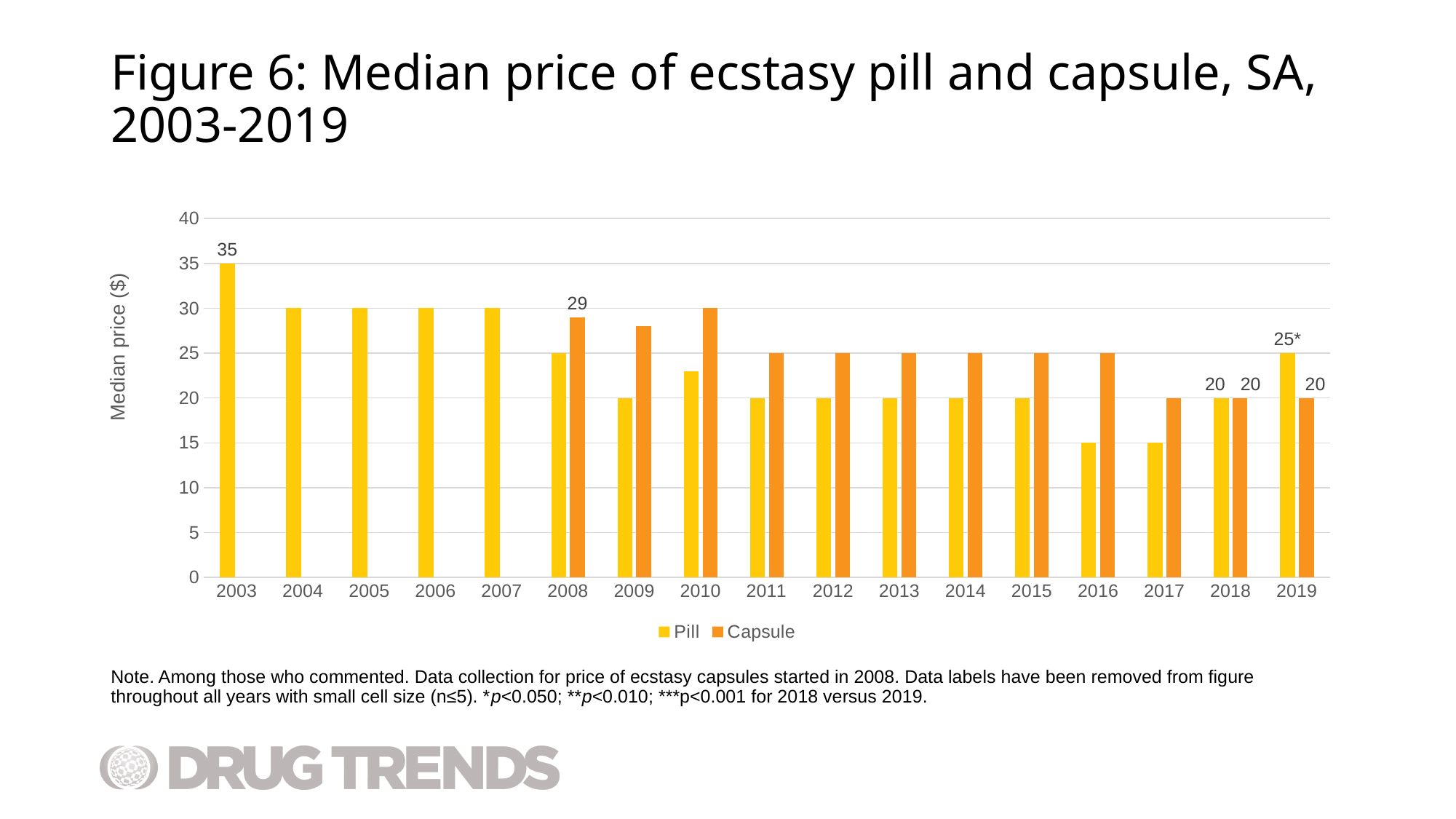
How many series does the legend list? 2 Is the median pill price in 2016 greater or less than 20? less What kind of chart is shown? Bar chart What is the median price of an ecstasy capsule in 2019? 20 Is the median capsule price in 2010 greater or less than 25? greater What is the difference between the median pill price in 2003 and the median pill price in 2018? 15 What is the median price of an ecstasy pill in 2019? 25* Which year has the highest median pill price? 2003 What is the median price of an ecstasy capsule in 2008? 29 Which is larger in 2019, the median price of a pill or of a capsule? Pill In which year does the Capsule series first appear on the chart? 2008 What is the median price of an ecstasy pill in 2003? 35